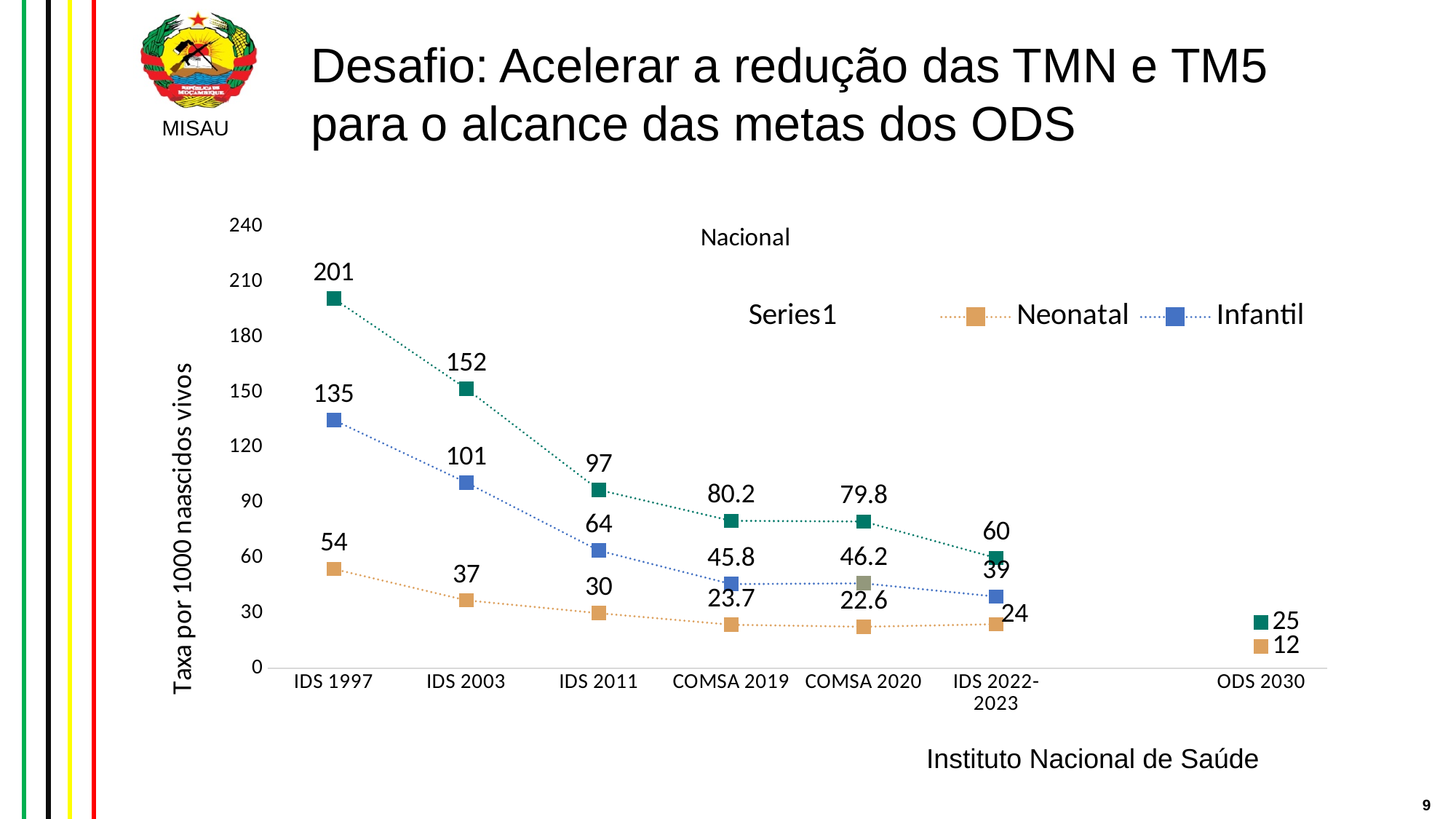
What is the Neonatal value for COMSA 2019? 23.7 At which category is the Neonatal series lowest? ODS 2030 What is the y-axis title of the chart? Taxa por 1000 naascidos vivos Does the Series1 line rise or fall from IDS 1997 to IDS 2022-2023? Fall What is the Series1 value for IDS 1997? 201 What kind of chart is shown on the slide? Line chart At which category is the Infantil series highest? IDS 1997 What is the difference between the Series1 values for IDS 2003 and IDS 2011? 55 What is the Infantil value for IDS 2011? 64 How many series does the legend list? 3 Which is larger, the Infantil value for COMSA 2019 or for COMSA 2020? COMSA 2020 What is the Neonatal value shown for ODS 2030? 12